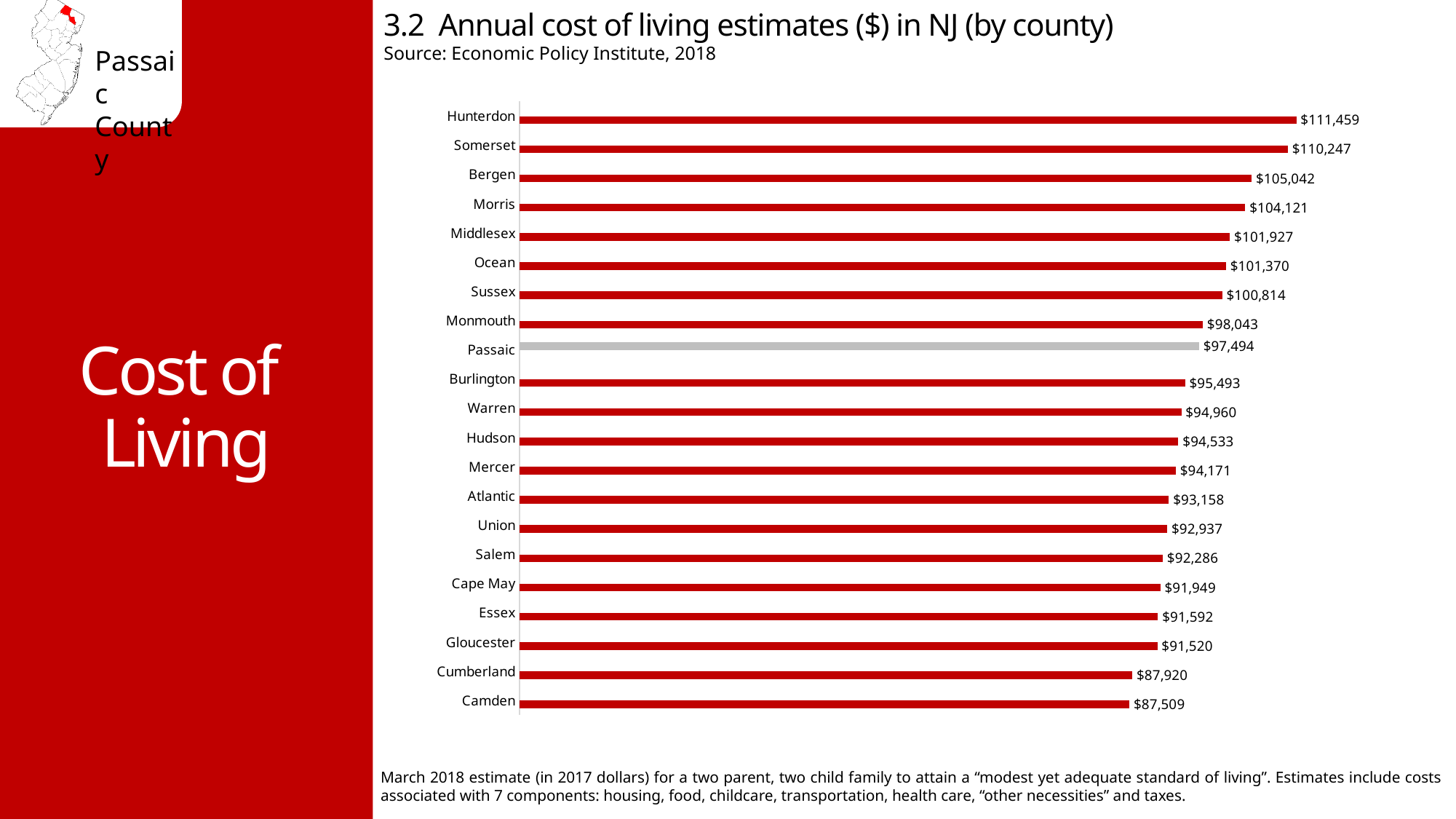
What type of chart is used on this slide? Bar chart What is the difference between the cost of living estimates for Monmouth and Passaic? $549 What is the annual cost of living estimate for Cumberland County? $87,920 Which county has the lowest annual cost of living estimate? Camden What is the annual cost of living estimate for Passaic County? $97,494 What is the difference between the cost of living estimates for Hunterdon and Camden? $23,950 What is the annual cost of living estimate for Bergen County? $105,042 What is the source cited for the chart? Economic Policy Institute, 2018 Which county has the highest annual cost of living estimate? Hunterdon Which county has a higher cost of living estimate, Morris or Ocean? Morris How many counties are shown in the chart? 21 Which county's bar is shown in grey instead of red? Passaic